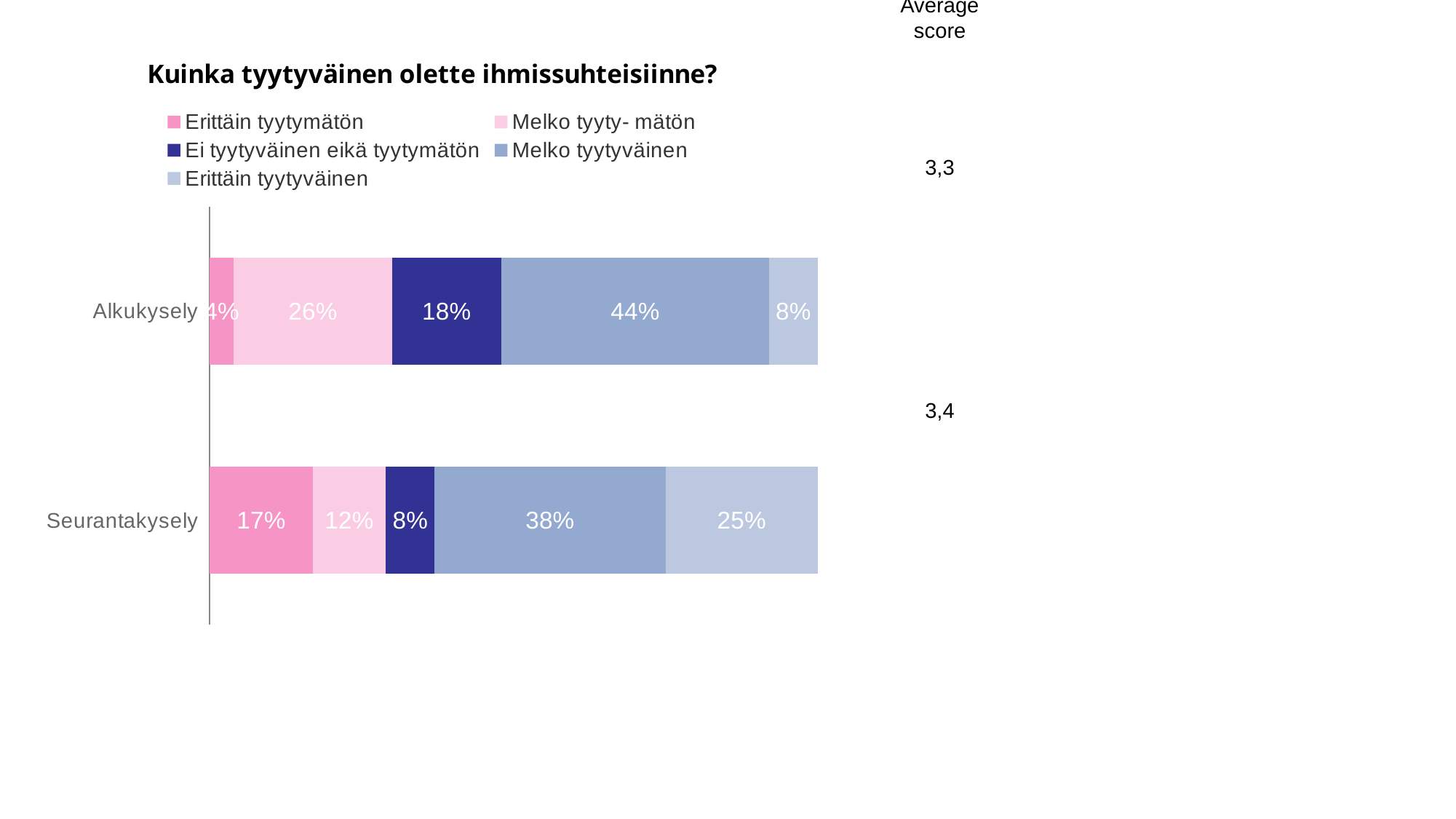
How many series does the legend list? 5 What is the title of the chart? Kuinka tyytyväinen olette ihmissuhteisiinne? What is the difference between the Erittäin tyytyväinen values for Seurantakysely and Alkukysely? 17% What is the value for Melko tyytyväinen in the Alkukysely bar? 44% Which segment is the largest in the Seurantakysely bar? Melko tyytyväinen Which is larger: Melko tyyty- mätön for Alkukysely or for Seurantakysely? Alkukysely What is the value for Erittäin tyytyväinen in the Seurantakysely bar? 25% How many categories (bars) does the chart show? 2 Which segment is the smallest in the Alkukysely bar? Erittäin tyytymätön What is the value for Erittäin tyytymätön in the Seurantakysely bar? 17% What kind of chart is shown on the slide? Stacked bar chart What is the value for Ei tyytyväinen eikä tyytymätön in the Alkukysely bar? 18%